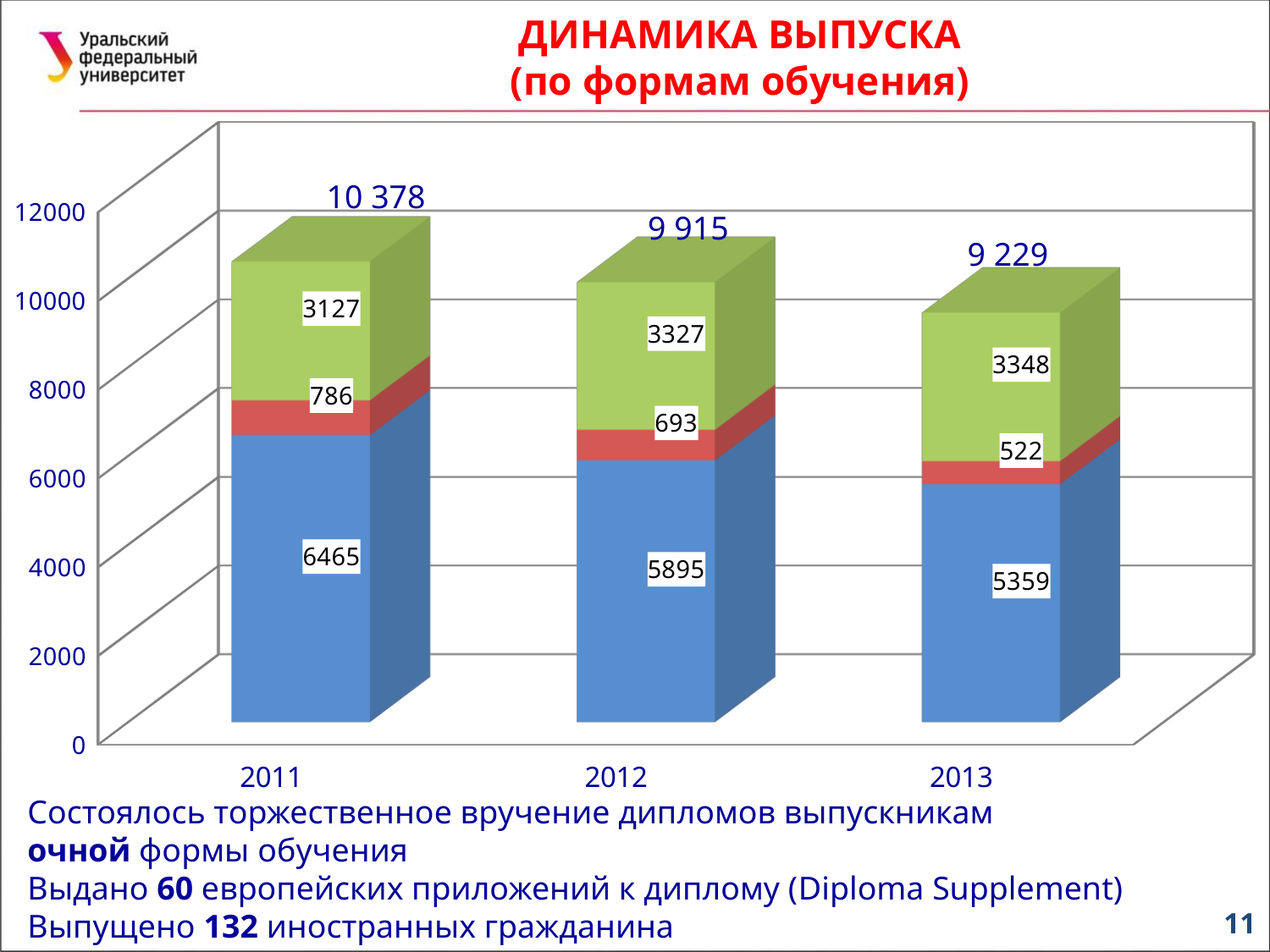
What is the difference between the totals for 2011 and 2013? 1 149 Which year has the highest total? 2011 Do the total values rise or fall from 2011 to 2013? Fall What is the title of the chart? ДИНАМИКА ВЫПУСКА (по формам обучения) What kind of chart is shown on the slide? Stacked bar chart What is the value of the red segment for 2013? 522 How many years are shown on the x axis? 3 What is the value of the green segment for 2011? 3127 What is the total value printed above the bar for 2011? 10 378 Which is larger, the green segment for 2012 or the green segment for 2013? 2013 Which year has the lowest value for the blue segment? 2013 What is the value of the blue segment for 2012? 5895